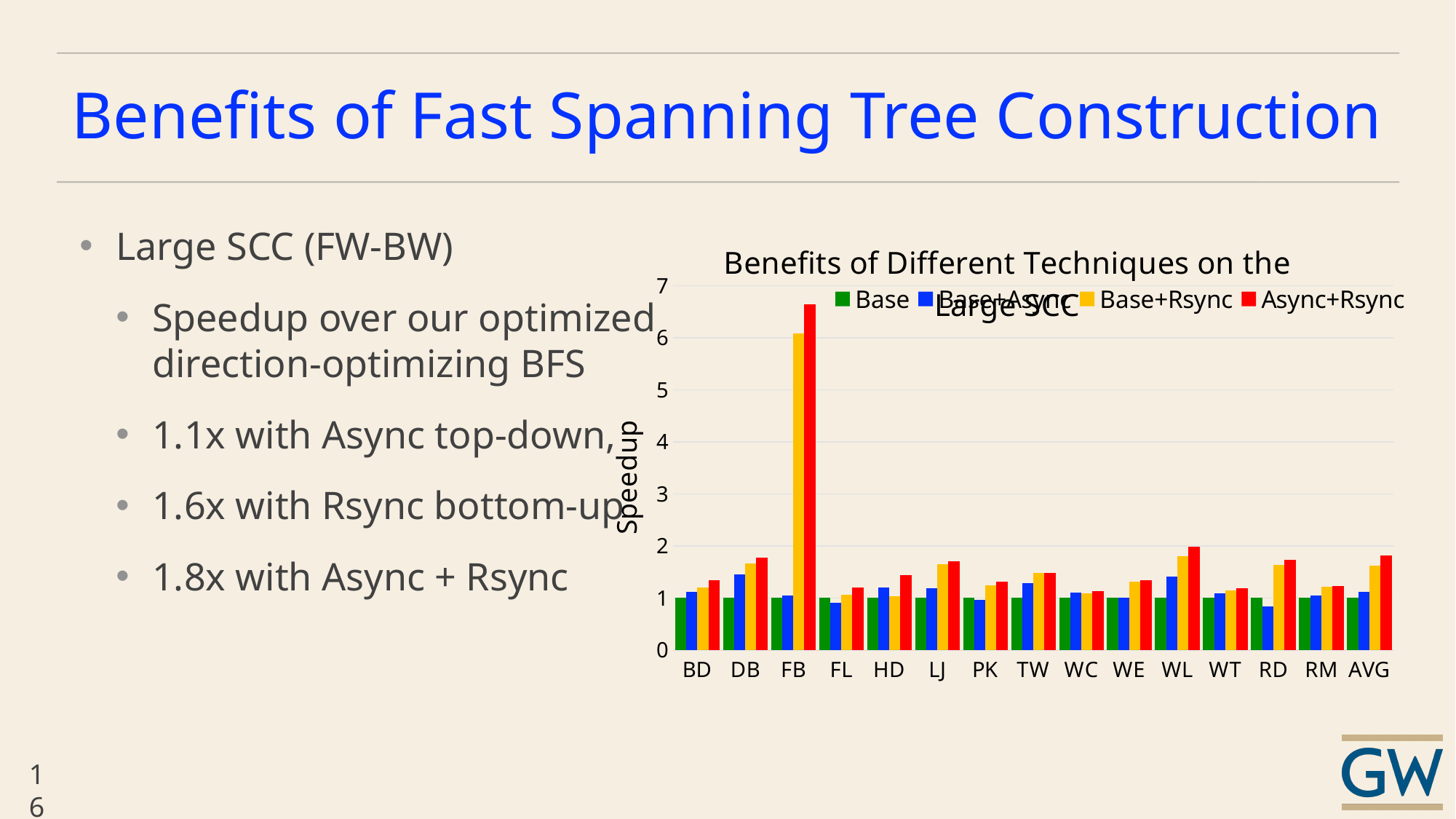
Is the Async+Rsync value for DB greater or less than 3? less How many categories are shown along the x axis of the chart? 15 How many series does the legend of the chart list? 4 Which series is shown in red in the chart? Async+Rsync What kind of chart is shown on the slide? bar chart What is the Base speedup value for BD? 1 Which is larger, the Async+Rsync value for FB or the Async+Rsync value for WL? FB Which category has the highest Async+Rsync speedup? FB Is the Base+Async value for RD greater or less than 1? less Is the Async+Rsync value for FB greater or less than 6? greater What is the label of the y axis of the chart? Speedup